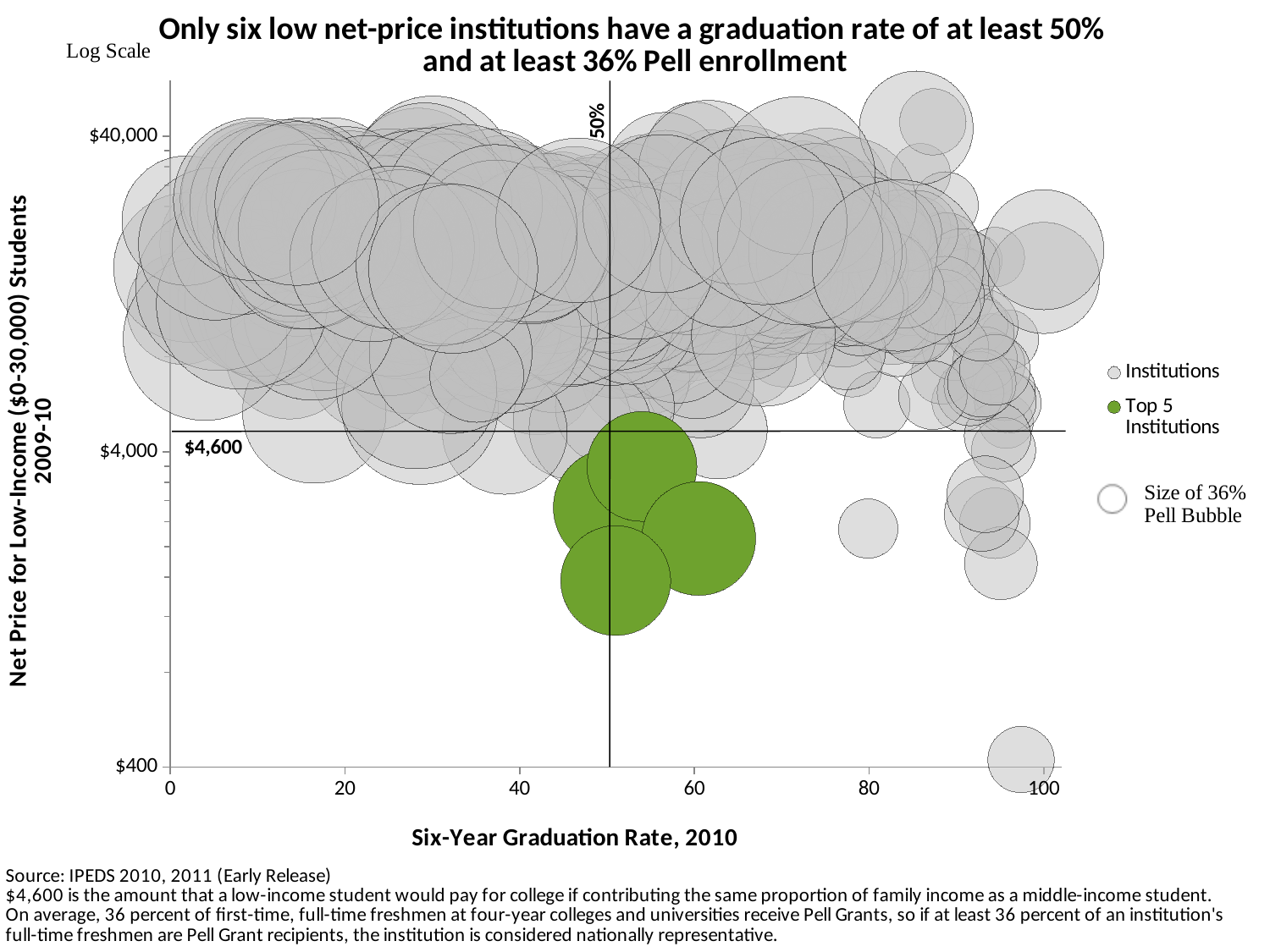
What net price value is marked by the horizontal reference line? $4,600 What is the title of the chart? Only six low net-price institutions have a graduation rate of at least 50% and at least 36% Pell enrollment Is the six-year graduation rate for the Top 5 Institutions bubbles greater or less than 80? less What kind of chart is shown on the slide? bubble chart What colour are the Top 5 Institutions bubbles? green Is the six-year graduation rate for the Top 5 Institutions bubbles greater or less than 40? greater What is the highest value labelled on the y axis? $40,000 Is the net price for the Top 5 Institutions bubbles greater or less than $400? greater How many series does the legend list? 2 What graduation rate is marked by the vertical reference line? 50%